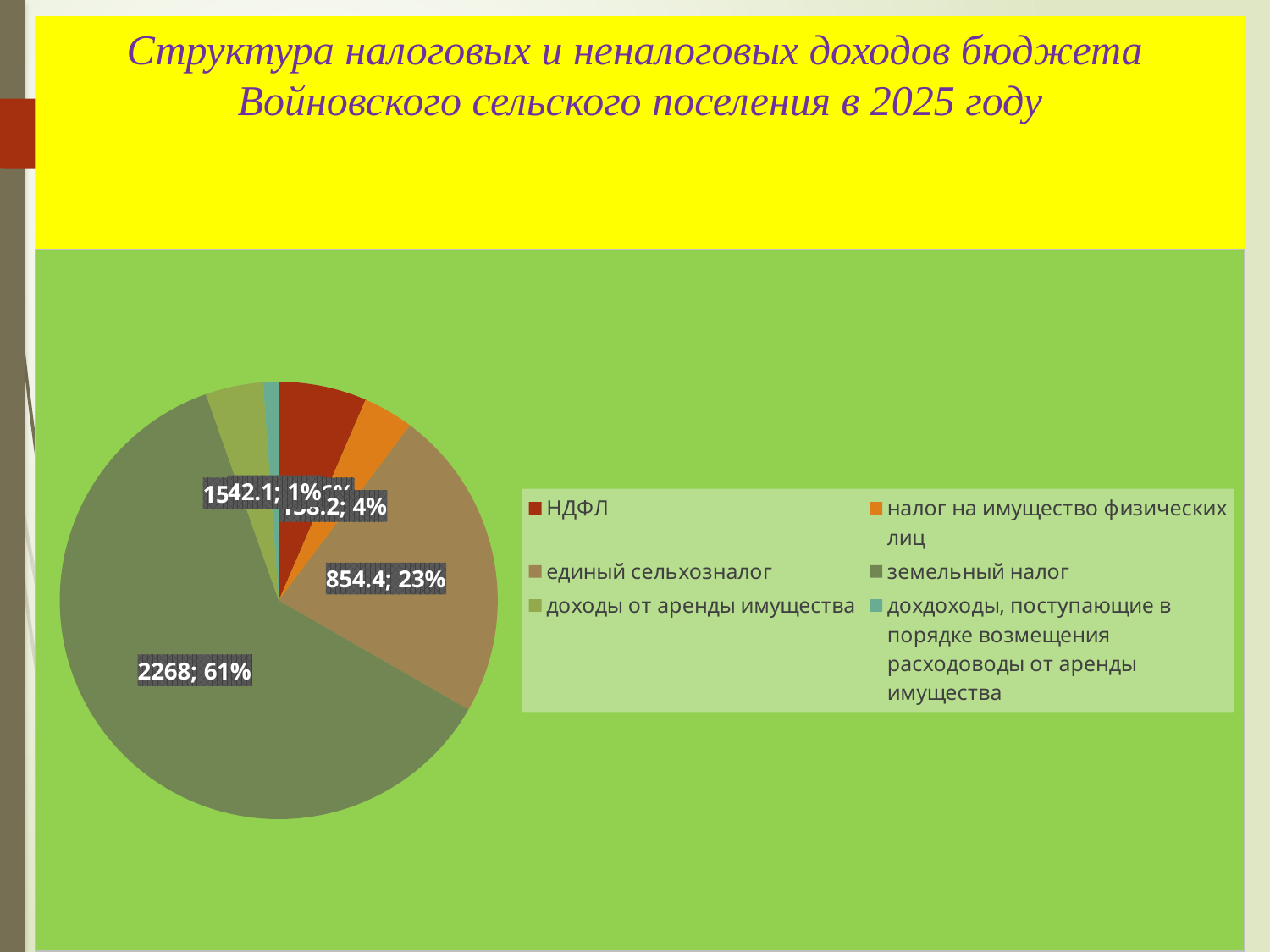
What value is shown for единый сельхозналог in the pie chart? 854.4 By how many percentage points does the share of земельный налог exceed the share of единый сельхозналог? 38% What kind of chart is shown on the slide? pie chart What is the difference between the values for земельный налог and единый сельхозналог? 1413.6 How many categories does the legend of the pie chart list? 6 Which category has the smallest slice in the pie chart? дохдоходы, поступающие в порядке возмещения расходоводы от аренды имущества What colour is used for НДФЛ in the pie chart? red What value is shown for земельный налог in the pie chart? 2268 What share of the pie does земельный налог represent? 61% What share of the pie does единый сельхозналог represent? 23% Which category has the largest slice in the pie chart? земельный налог Which is larger: the slice for НДФЛ or the slice for налог на имущество физических лиц? НДФЛ